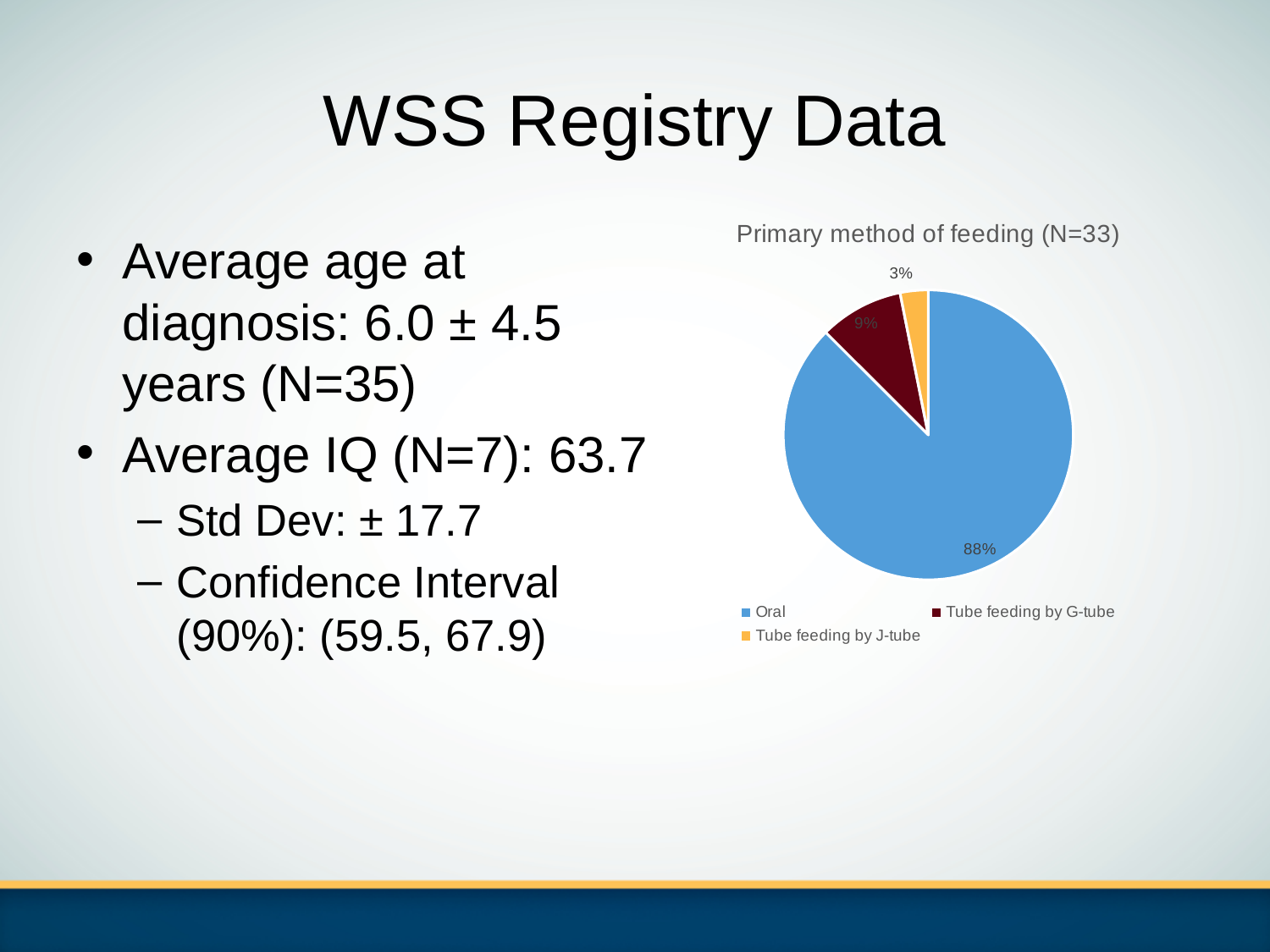
Which category has the smallest slice of the pie? Tube feeding by J-tube What share of the pie is Tube feeding by G-tube? 9% What type of chart is shown on the slide? pie chart What share of the pie is Tube feeding by J-tube? 3% How many entries does the legend list? 3 Which is larger, the share for Tube feeding by G-tube or Tube feeding by J-tube? Tube feeding by G-tube What is the title of the chart? Primary method of feeding (N=33) What colour is the Oral slice? blue What is the difference in percentage points between Oral and Tube feeding by G-tube? 79 Which category has the largest slice of the pie? Oral How many categories does the pie chart show? 3 What share of the pie is Oral? 88%